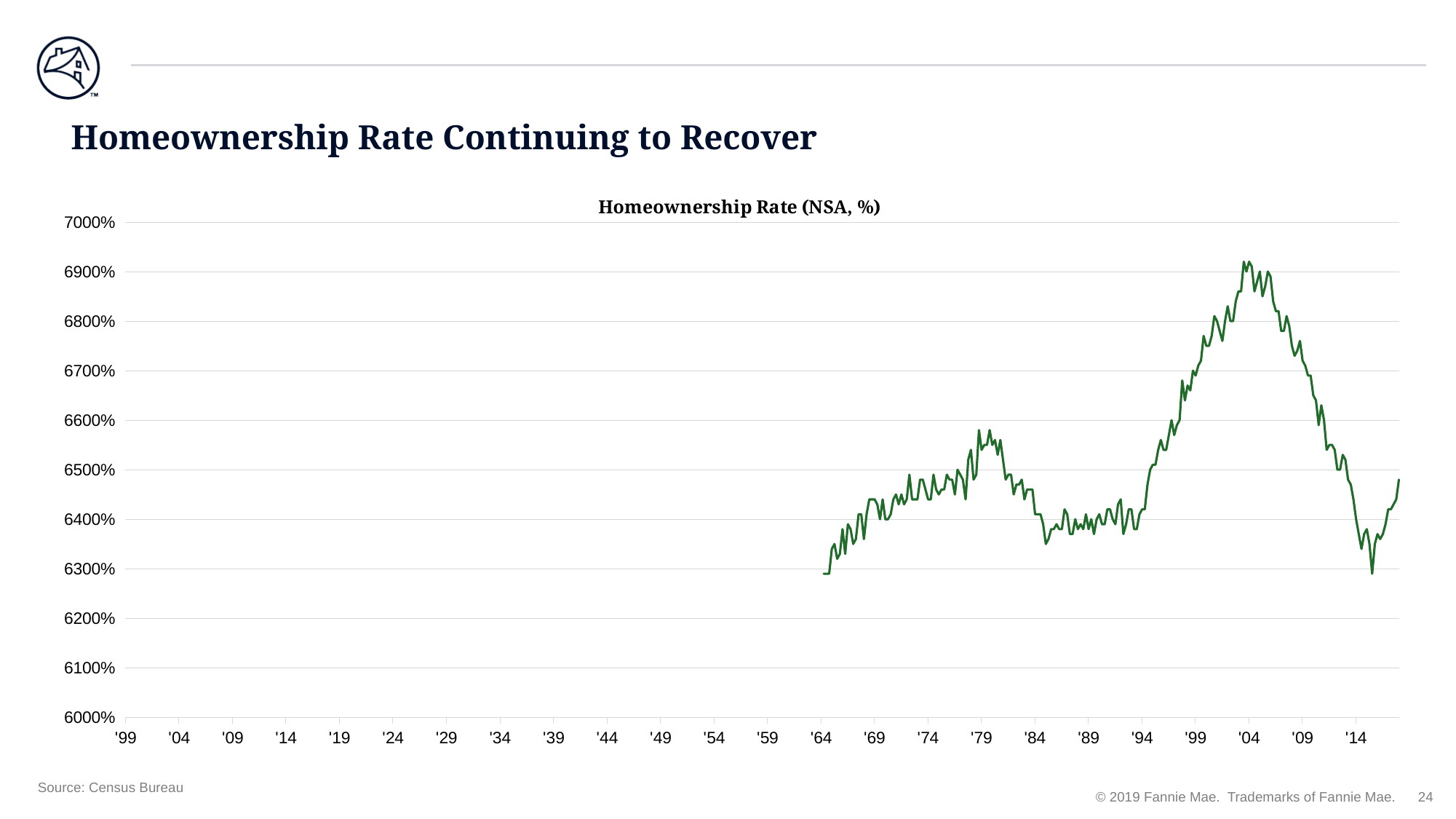
Is the value of the homeownership rate line around '89 greater or less than 6500%? less What kind of chart is shown on the slide? line chart Which is larger, the value of the line near '04 or the value near '79? '04 Does the homeownership rate line rise or fall between '04 and '14? fall What is the title of the chart? Homeownership Rate (NSA, %) Does the homeownership rate line rise or fall between '94 and '04? rise Is the value of the homeownership rate line at its peak near '04 greater or less than 6800%? greater Is the value of the homeownership rate line around '09 greater or less than 6600%? greater Near which x-axis year label does the homeownership rate line reach its highest point? '04 What is the highest value shown on the y axis of the chart? 7000%